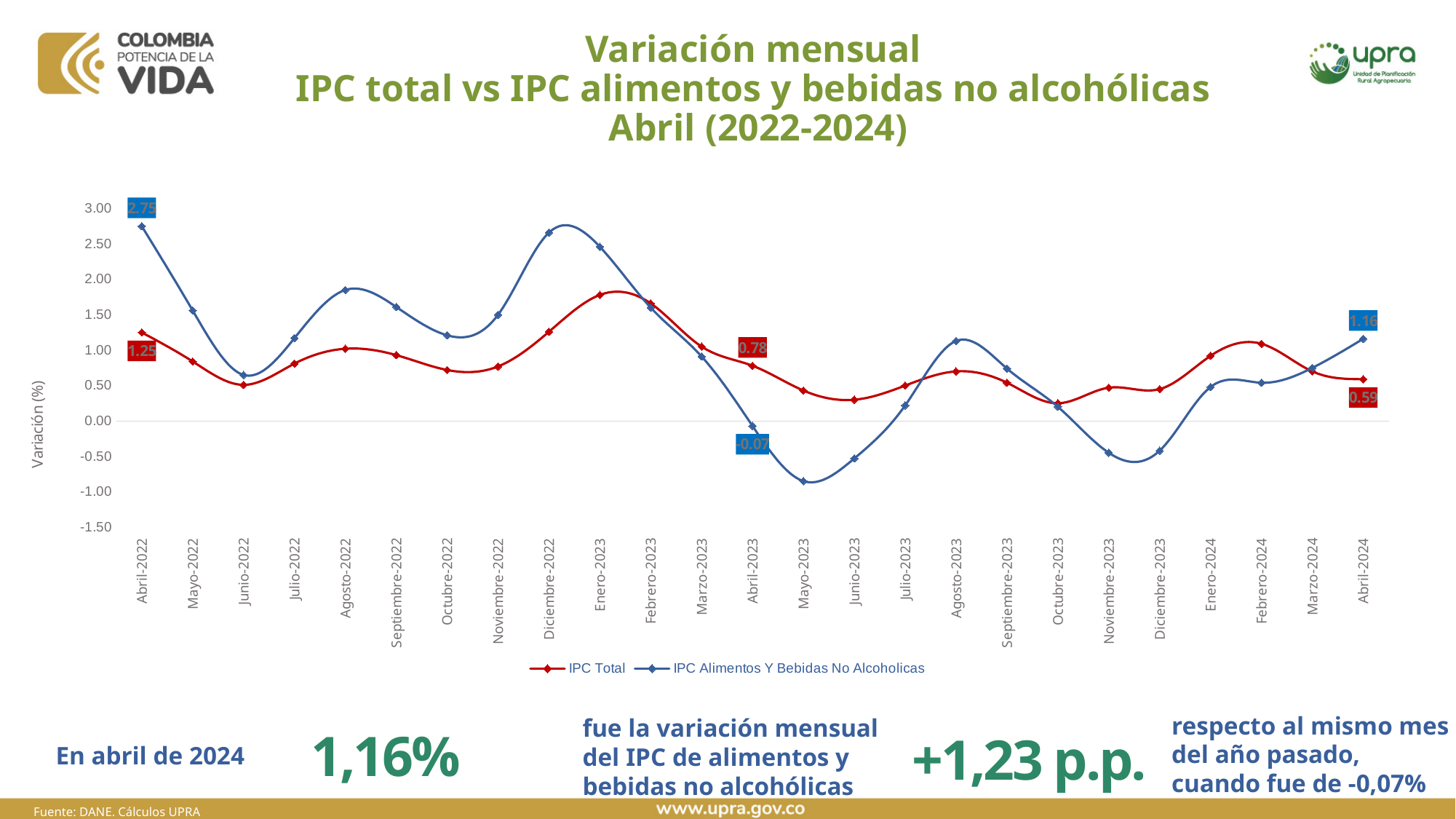
Which series has the larger value in Abril-2023, IPC Total or IPC Alimentos Y Bebidas No Alcoholicas? IPC Total What is the value of IPC Total for Abril-2022? 1.25 What is the value of IPC Total for Abril-2023? 0.78 What is the value of IPC Alimentos Y Bebidas No Alcoholicas for Abril-2023? -0.07 In which month does IPC Alimentos Y Bebidas No Alcoholicas reach its lowest value? Mayo-2023 What is the value of IPC Alimentos Y Bebidas No Alcoholicas for Abril-2022? 2.75 What is the value of IPC Alimentos Y Bebidas No Alcoholicas for Abril-2024? 1.16 How many months are plotted along the x axis? 25 What kind of chart is shown on the slide? Line chart What is the value of IPC Total for Abril-2024? 0.59 How many series does the legend list? 2 What is the difference between IPC Alimentos Y Bebidas No Alcoholicas and IPC Total in Abril-2024? 0.57